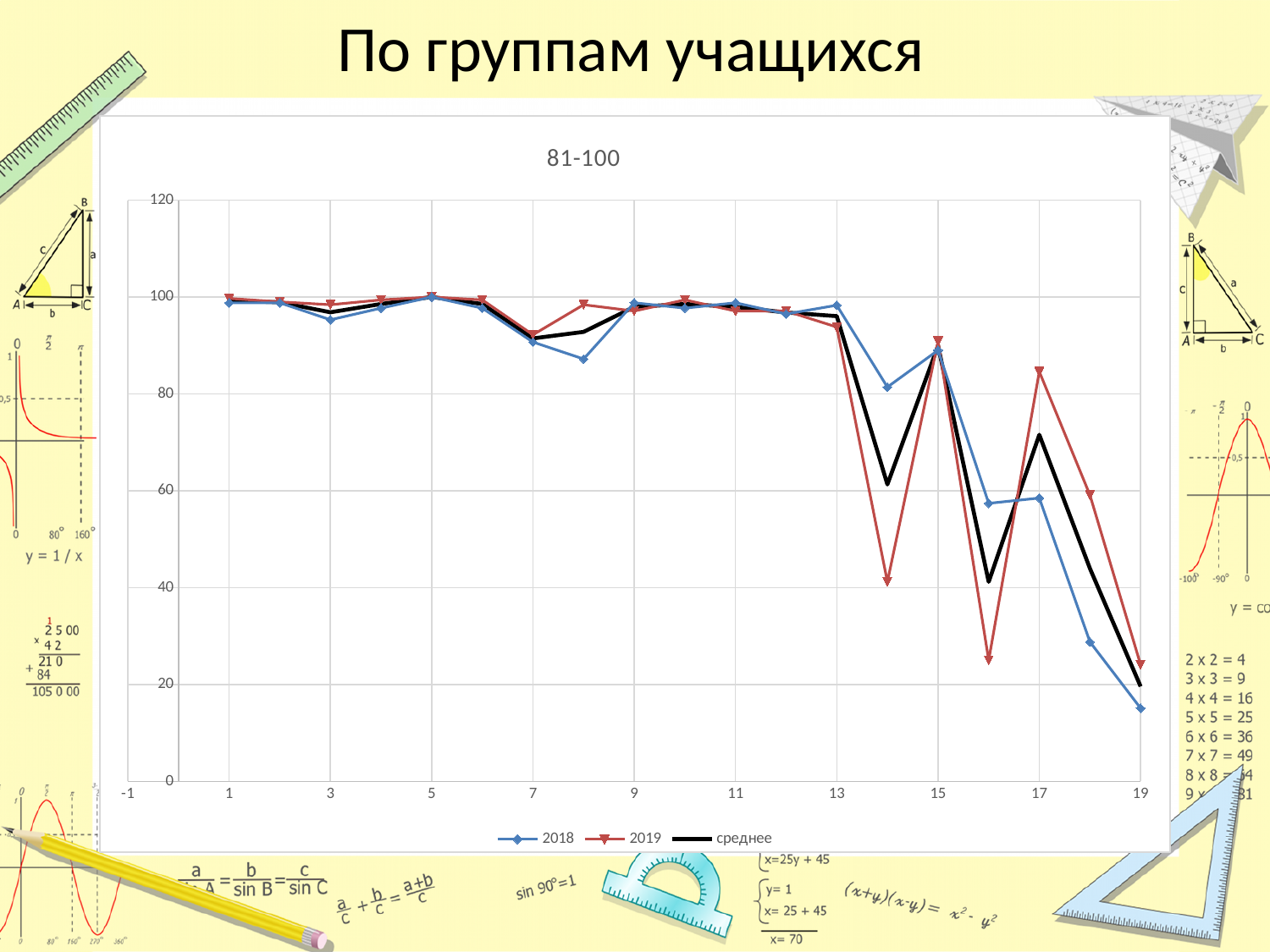
Is the value of the среднее series at x = 16 greater or less than 60? less At x = 14, which series has the larger value, 2018 or 2019? 2018 At x = 17, which series has the larger value, 2018 or 2019? 2019 Is the value of the 2019 series at x = 14 greater or less than 60? less Is the value of the 2018 series at x = 19 greater or less than 20? less Which series is drawn as a thick black line? среднее At which x value does the 2018 series reach its lowest point? 19 How many series does the legend list? 3 What kind of chart is shown on the slide? line chart What is the title of the chart? 81-100 How many data points does each series have? 19